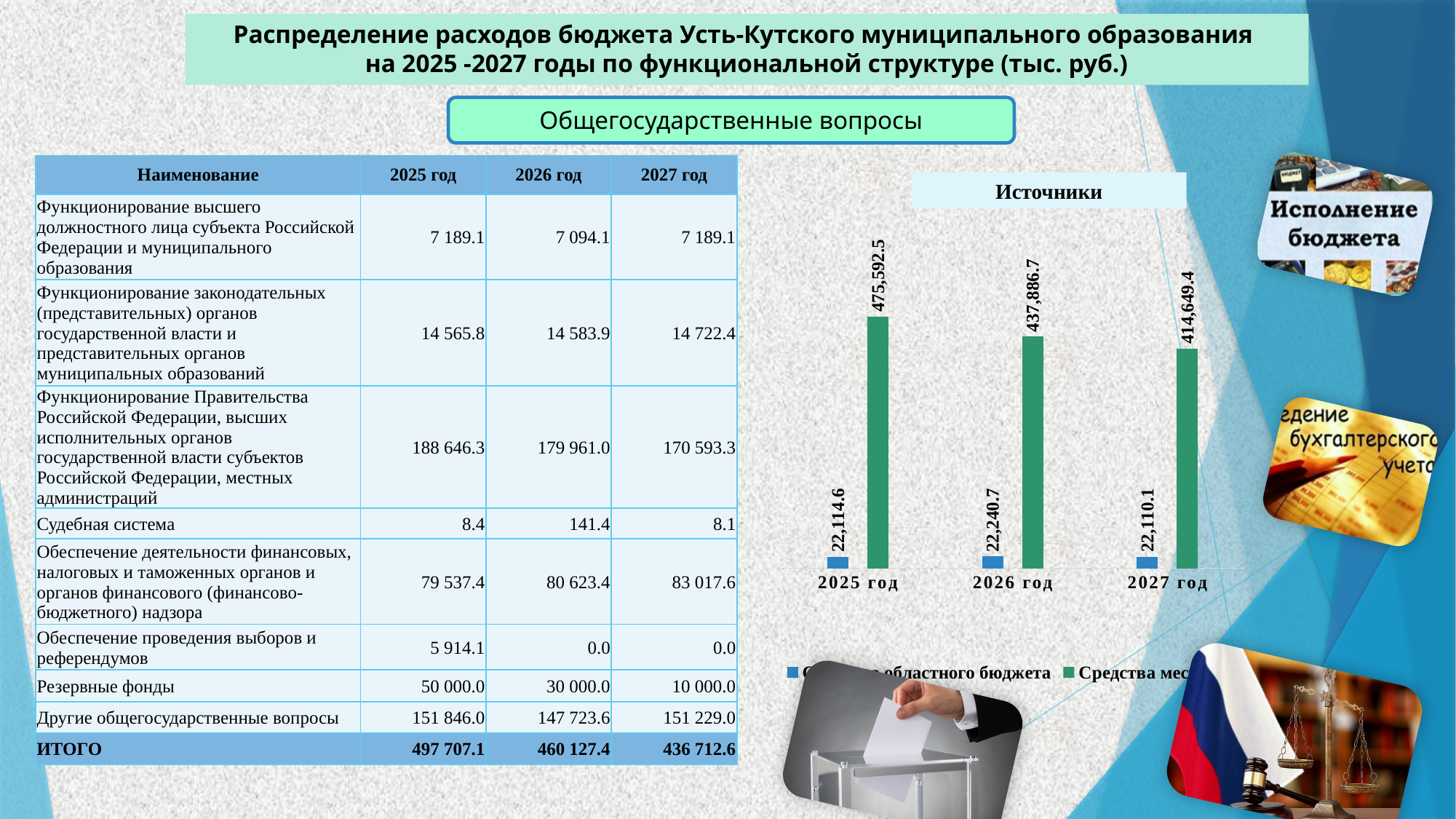
What kind of chart is the chart titled "Источники"? bar chart In the chart titled "Источники", what is the value of the green bar for 2027 год? 414,649.4 In the chart titled "Источники", which year has the lowest green bar? 2027 год How many year categories are shown on the x axis of the chart titled "Источники"? 3 In the chart titled "Источники", which year has the highest green bar? 2025 год In the chart titled "Источники", which is larger for 2025 год: the blue bar or the green bar? the green bar In the chart titled "Источники", what is the value of the green bar for 2025 год? 475,592.5 In the chart titled "Источники", what is the difference between the green bar values for 2025 год and 2026 год? 37,705.8 In the chart titled "Источники", what is the difference between the green bar values for 2026 год and 2027 год? 23,237.3 How many series does the legend of the chart titled "Источники" list? 2 In the chart titled "Источники", what is the value of the blue bar for 2025 год? 22,114.6 In the chart titled "Источники", what is the value of the blue bar for 2026 год? 22,240.7